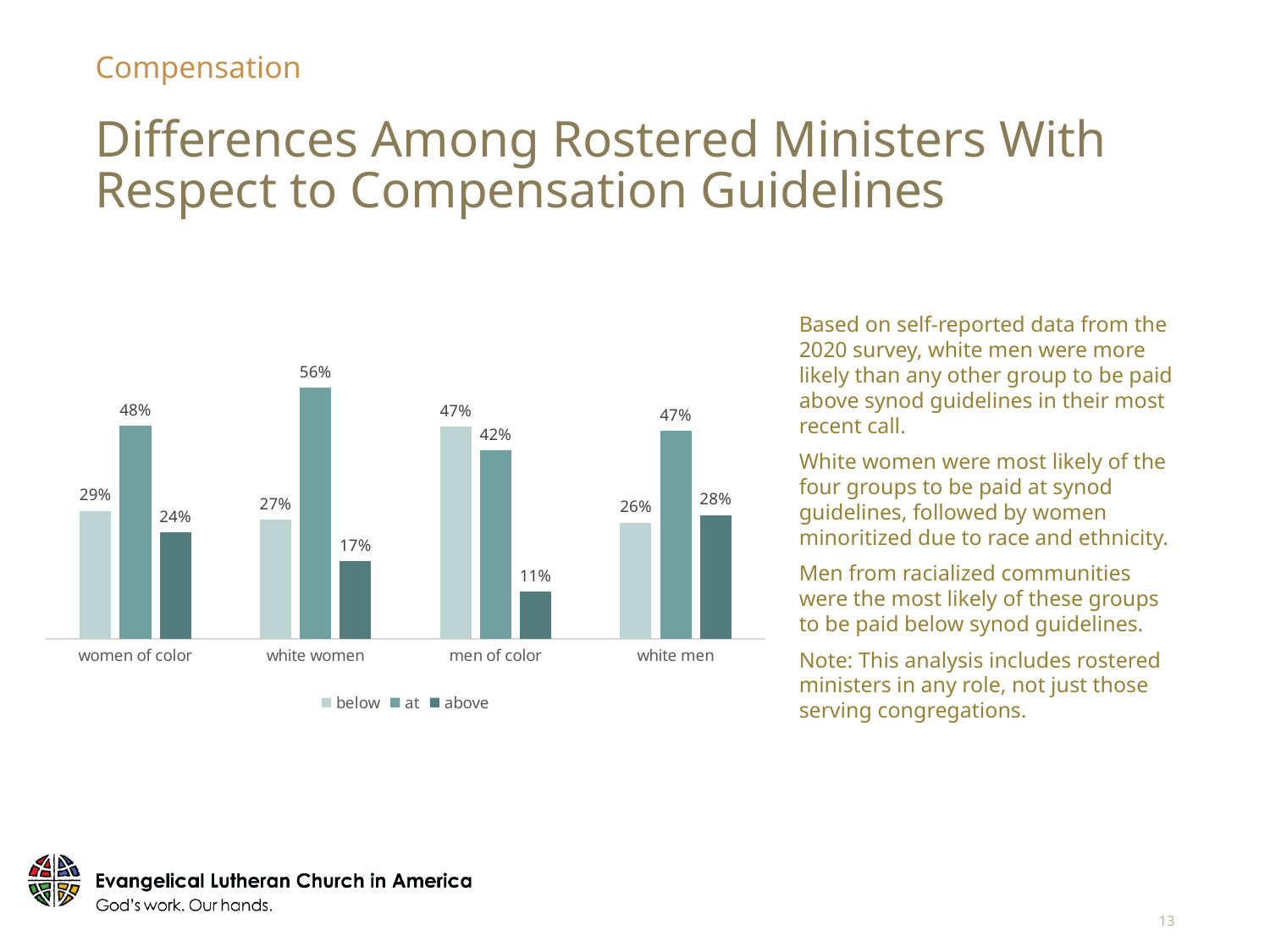
What kind of chart is shown on the slide? bar chart How many series does the legend list? 3 What is the difference between the 'at' and 'above' values for women of color? 24% What is the value for 'below' for men of color? 47% What are the three series listed in the legend? below, at, above How many groups are shown on the x axis? 4 Which is larger: the 'below' value for men of color or the 'below' value for white men? men of color What percentage of white women are paid at synod guidelines? 56% Which group has the highest 'at' value? white women Which group has the highest 'above' value? white men What is the value for 'above' for white men? 28% Which group has the lowest 'above' value? men of color